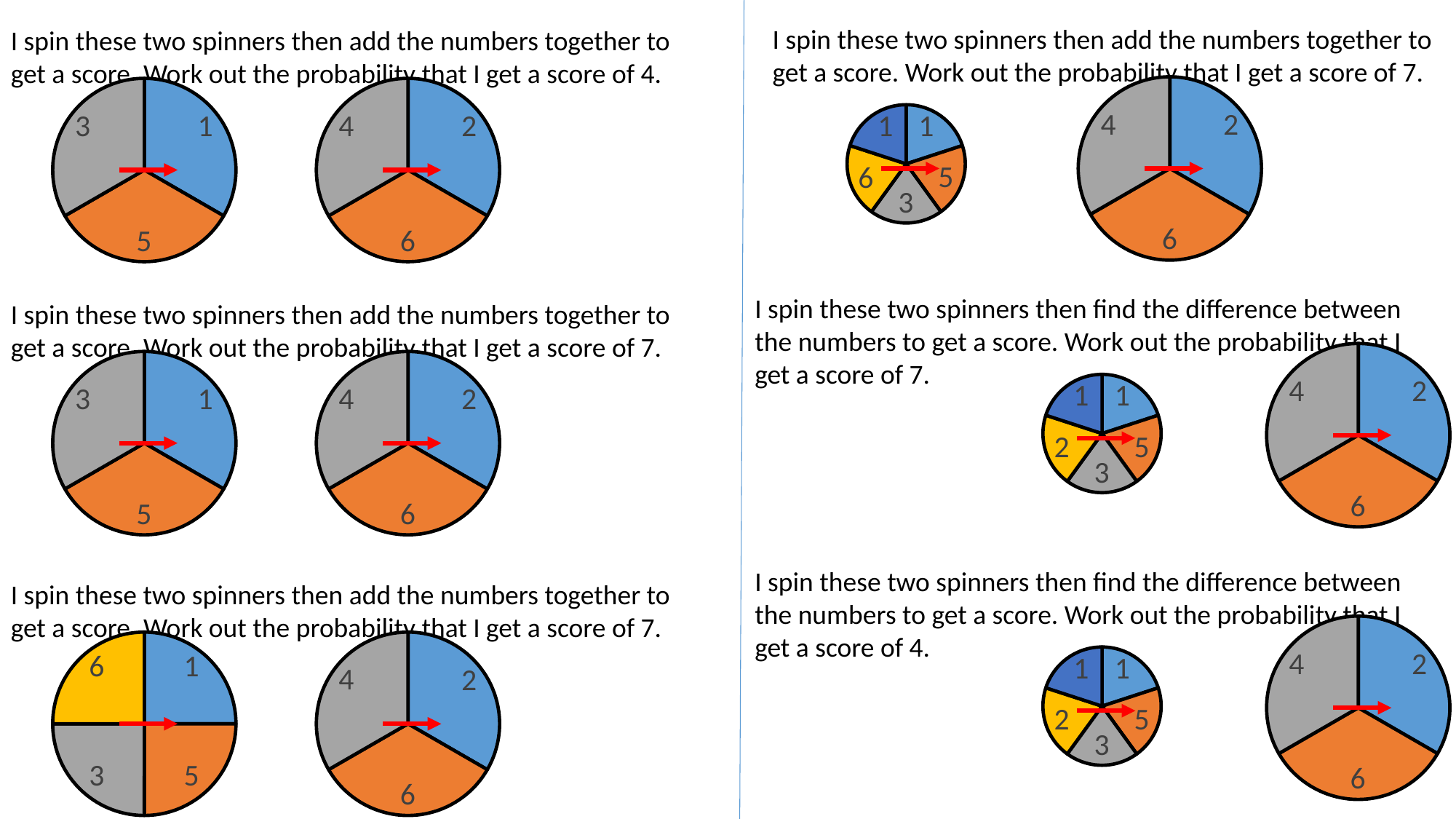
What numbers appear on the right spinner in the top-left question? 2, 6, 4 How many sections does the left spinner in the bottom-left question have? 4 What number is in the yellow section of the small spinner in the top-right question? 6 What colour is the section labelled 4 on the right spinner in the top-left question? grey What number is in the yellow section of the small spinner in the middle-right question? 2 What number is in the orange section of the left spinner in the top-left question? 5 How many spinners are shown on the slide in total? 12 What number is in the yellow section of the left spinner in the bottom-left question? 6 What kind of chart are the spinners on the slide drawn as? pie chart How many sections does the left spinner in the top-left question have? 3 What score does the top-left question ask for the probability of? 4